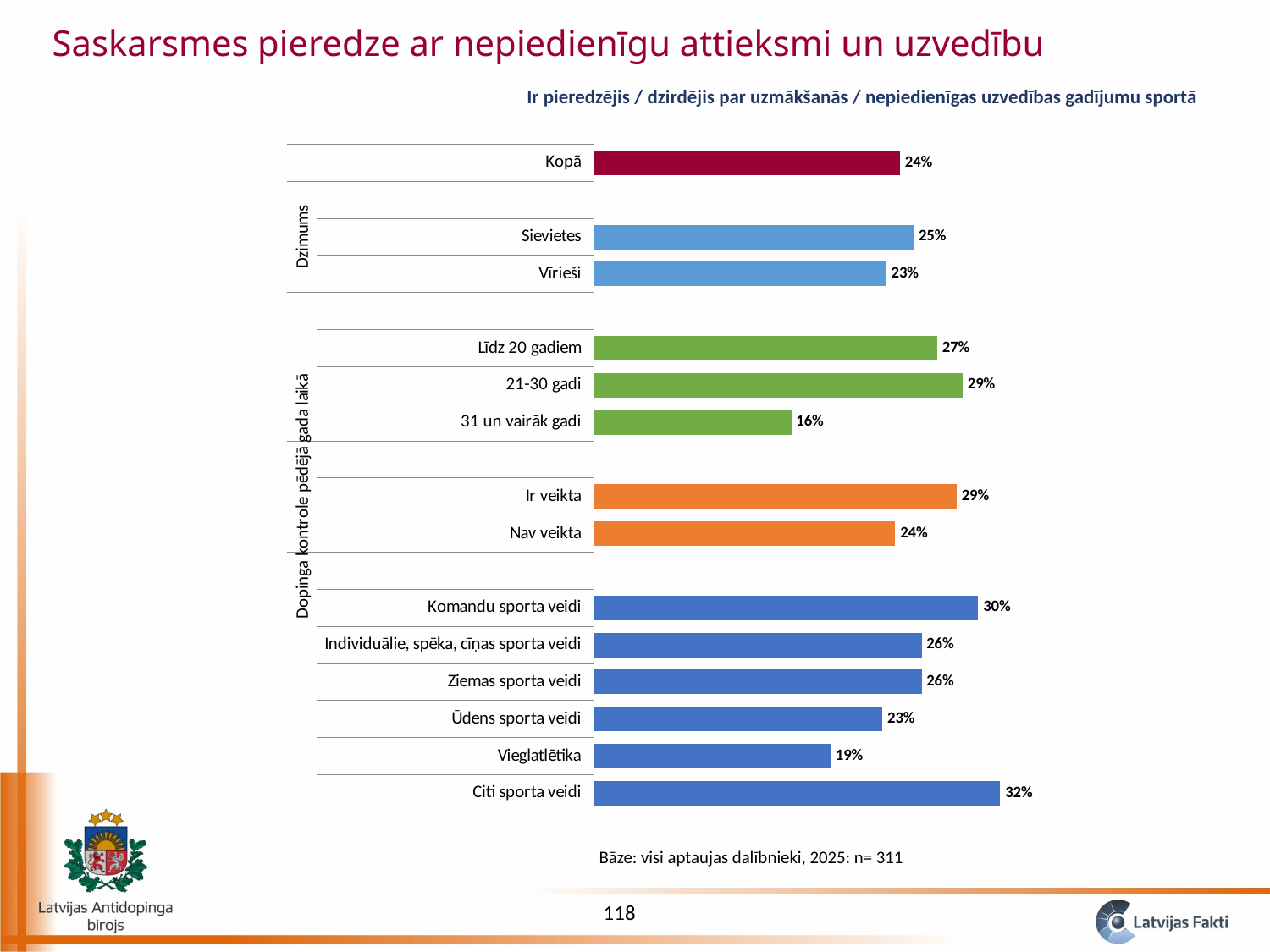
What is the difference between the values for 21-30 gadi and 31 un vairāk gadi? 13% What is the value for Vieglatlētika? 19% Which is larger, the value for Ir veikta or the value for Nav veikta? Ir veikta Which category has the lowest value? 31 un vairāk gadi What is the difference between the values for Sievietes and Vīrieši? 2% What is the value for Sievietes? 25% What is the value for Kopā? 24% Which category has the highest value? Citi sporta veidi What kind of chart is shown on the slide? Bar chart How many bars are plotted in the chart? 14 What is the value for 31 un vairāk gadi? 16% What is the value for Komandu sporta veidi? 30%